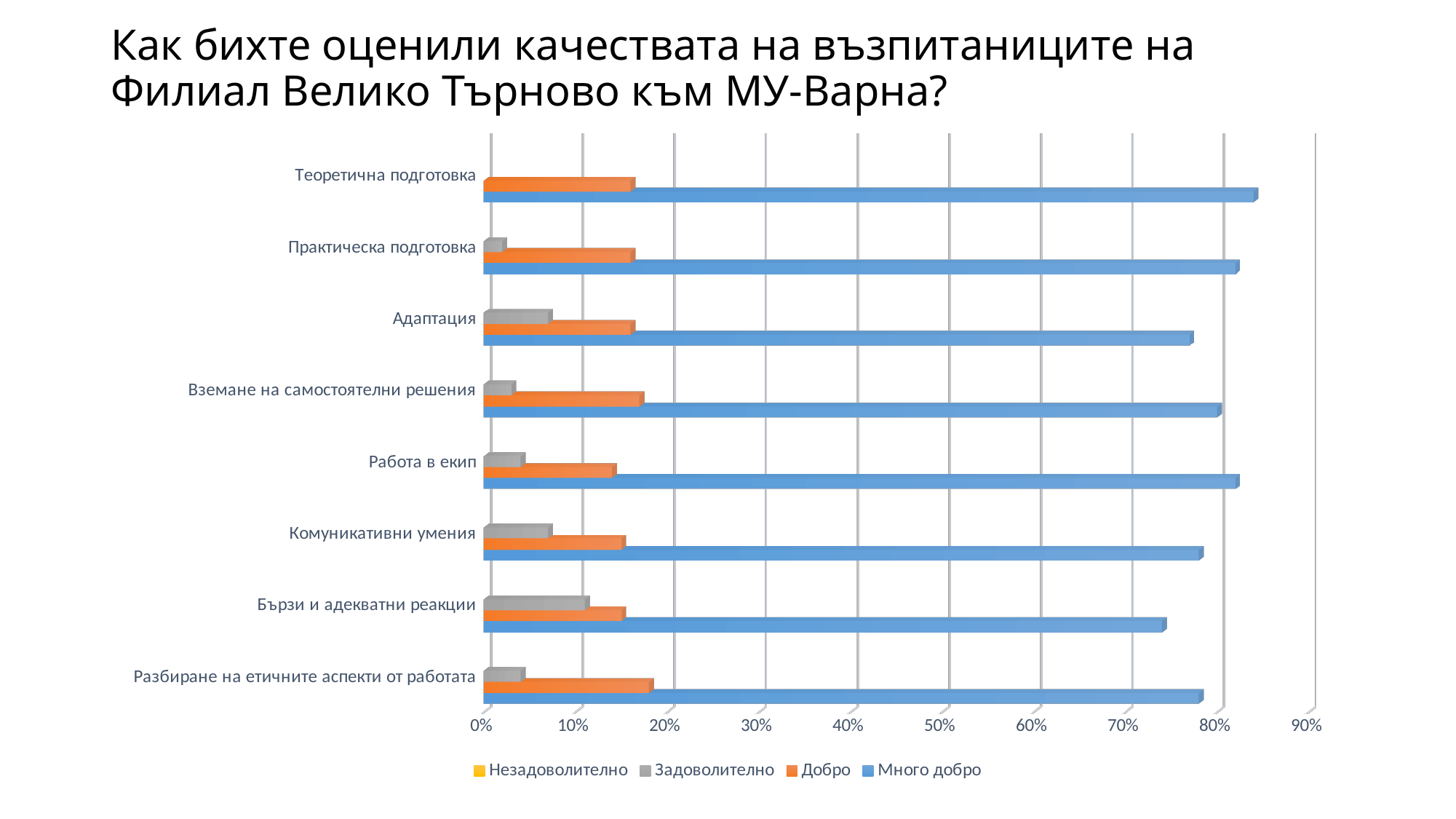
Which is larger: the 'Добро' value for 'Разбиране на етичните аспекти от работата' or for 'Работа в екип'? Разбиране на етичните аспекти от работата Which category has the highest value for the 'Задоволително' series? Бързи и адекватни реакции Which category has the lowest value for the 'Много добро' series? Бързи и адекватни реакции How many series does the legend list? 4 Is the 'Добро' value for 'Разбиране на етичните аспекти от работата' greater or less than 20%? less Is the 'Много добро' value for 'Бързи и адекватни реакции' greater or less than 80%? less How many categories are plotted on the chart? 8 Is the 'Много добро' value for 'Теоретична подготовка' greater or less than 80%? greater Which category has the highest value for the 'Много добро' series? Теоретична подготовка Which colour represents the 'Много добро' series in the legend? Blue What kind of chart is shown on the slide? Bar chart